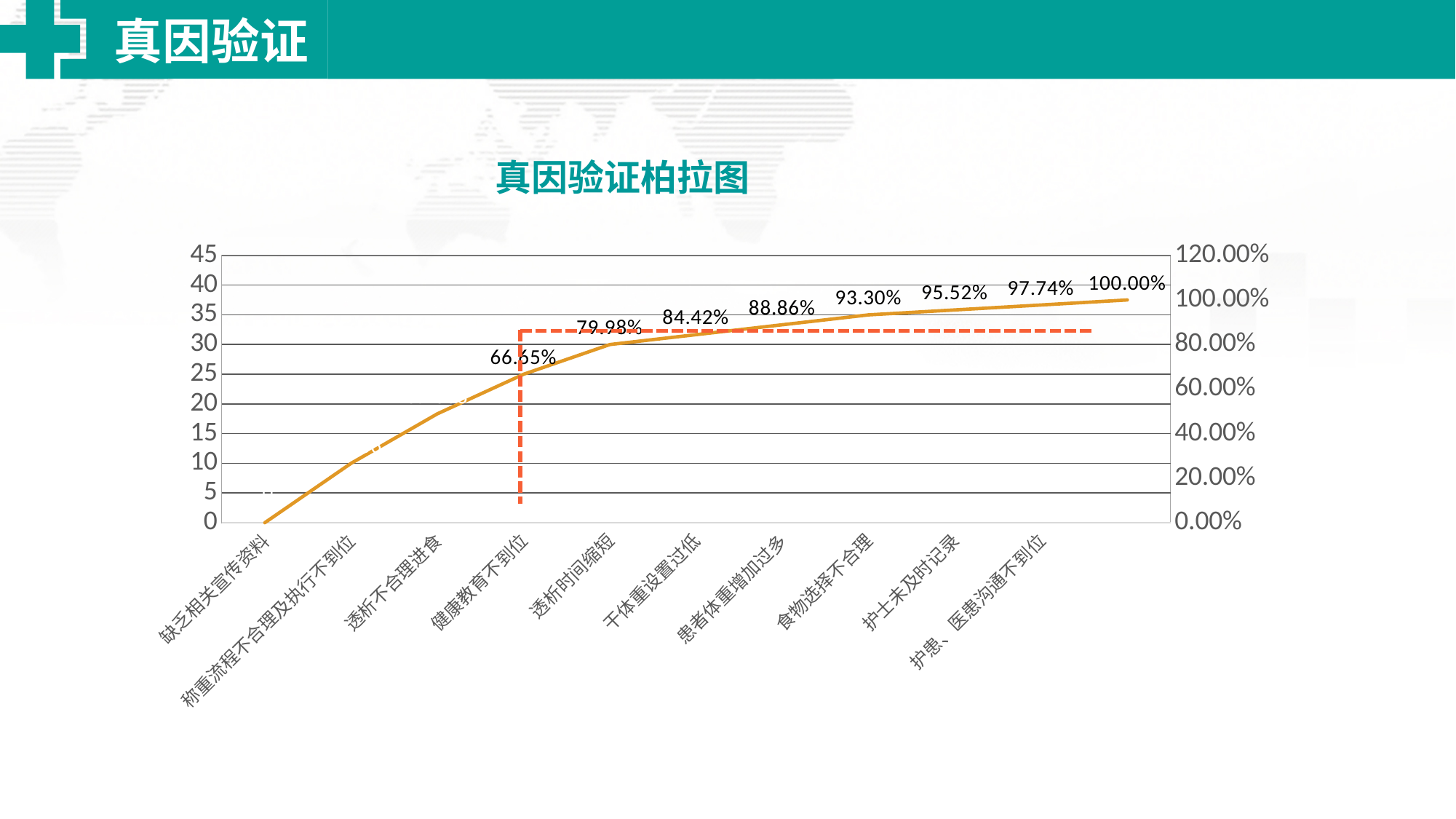
What is the difference between the 79.98% label and the 66.65% label on the line? 13.33% What is the title of the chart on the slide? 真因验证柏拉图 What is the difference between the 100.00% label and the 97.74% label on the line? 2.26% What is the lowest cumulative percentage label printed on the line? 66.65% What is the maximum value shown on the right vertical axis? 120.00% How many categories are listed along the x axis of the chart? 10 Does the cumulative percentage line rise or fall from left to right? rise What is the maximum value shown on the left vertical axis? 45 Which cumulative percentage label comes immediately after 79.98% on the line? 84.42% What is the highest cumulative percentage label printed on the line? 100.00% What is the first category on the x axis of the chart? 缺乏相关宣传资料 What kind of chart is shown on the slide? line chart (Pareto chart)